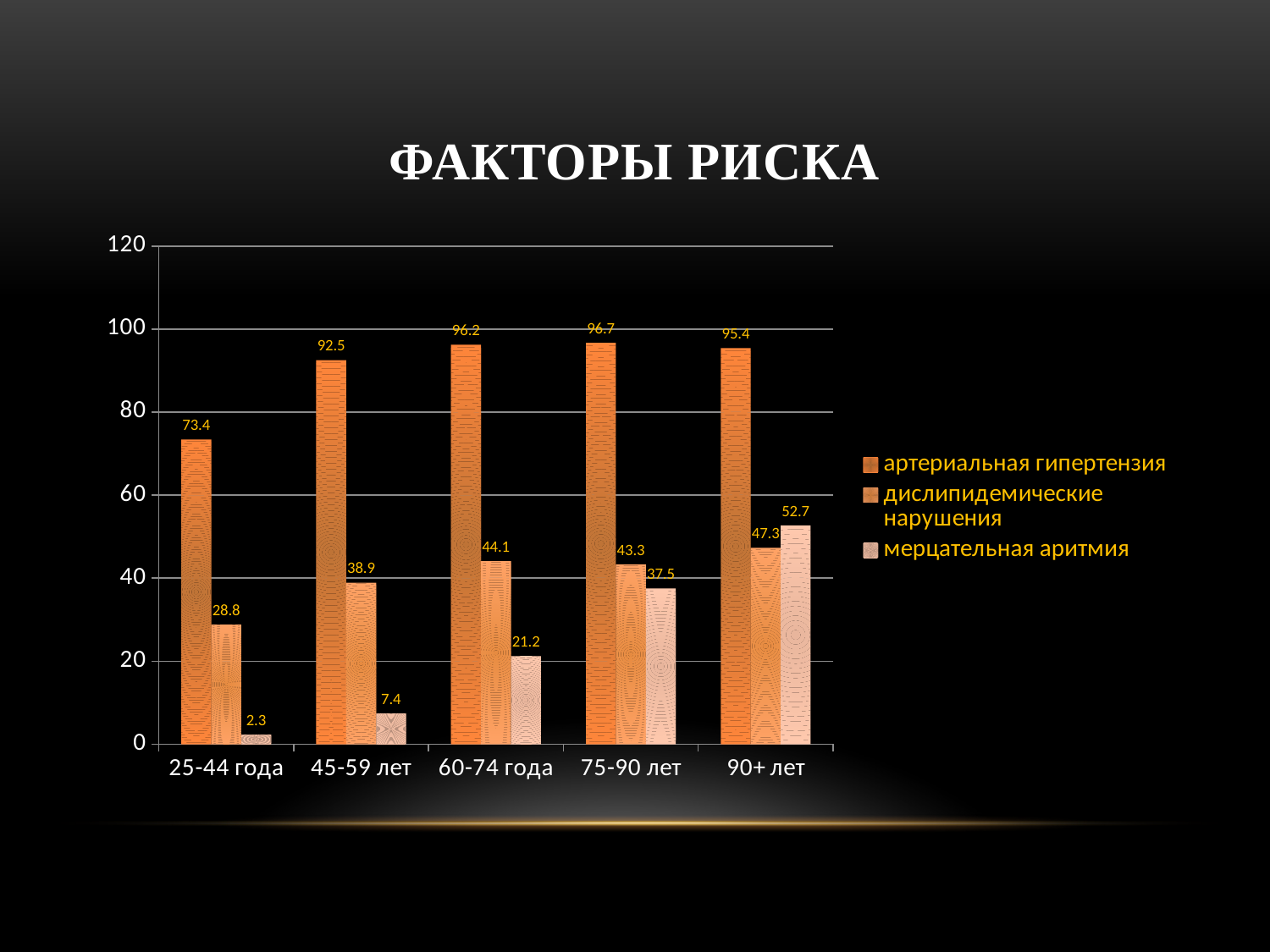
Which age group has the lowest value for мерцательная аритмия? 25-44 года Which age group has the highest value for артериальная гипертензия? 75-90 лет What is the title of the chart? ФАКТОРЫ РИСКА What is the value for дислипидемические нарушения in the 60-74 года group? 44.1 In the 90+ лет group, which is larger: дислипидемические нарушения or мерцательная аритмия? мерцательная аритмия Do the values for мерцательная аритмия rise or fall from 25-44 года to 90+ лет? rise How many series does the legend list? 3 What is the value for артериальная гипертензия in the 25-44 года group? 73.4 What type of chart is shown on the slide? bar chart What is the value for мерцательная аритмия in the 90+ лет group? 52.7 What is the difference between артериальная гипертензия and дислипидемические нарушения in the 45-59 лет group? 53.6 How many age groups are shown on the x axis? 5